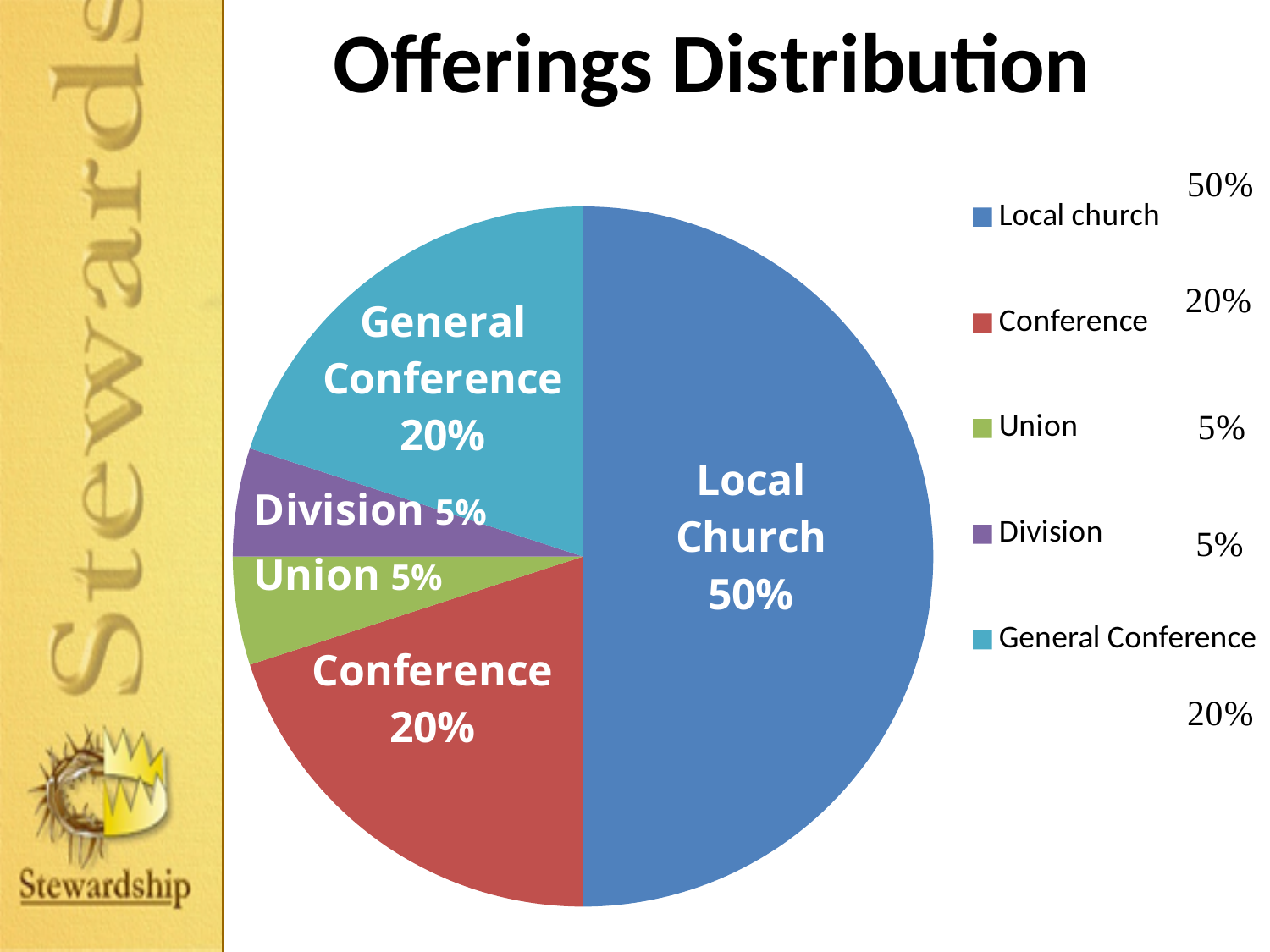
Which category receives the largest share of offerings? Local Church What colour is the Local church slice in the pie chart? Blue What is the title of the chart? Offerings Distribution What share of offerings goes to the Union? 5% What share of offerings goes to the Local Church? 50% What share of offerings goes to the Division? 5% How many categories are shown in the pie chart? 5 What is the difference between the Local Church share and the Conference share? 30% What kind of chart is shown on the slide? Pie chart Which is larger, the share for the Conference or the share for the Union? Conference